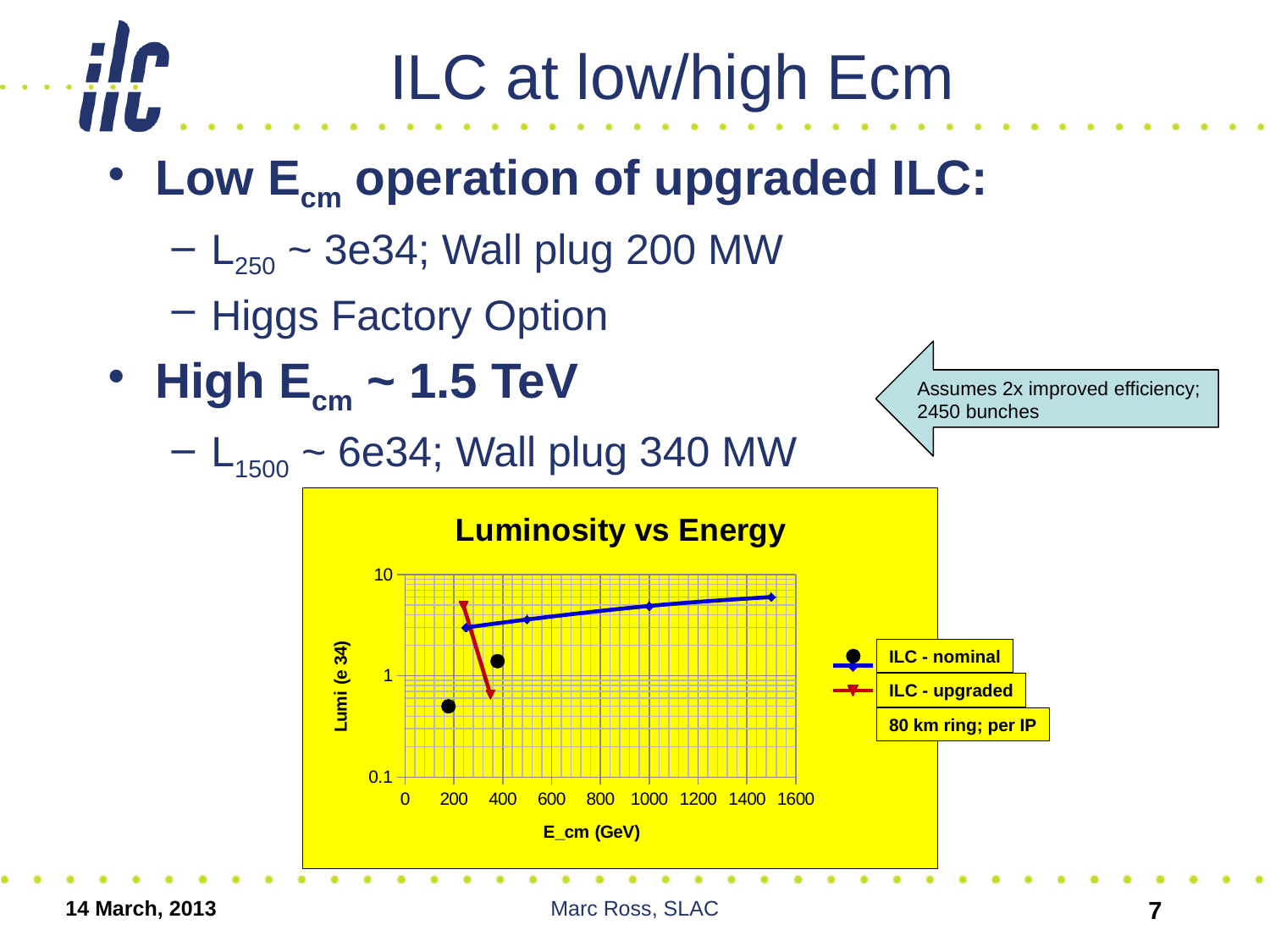
Is the ILC - upgraded luminosity at 1500 GeV greater or less than 1? greater How many entries does the chart's legend list? 3 Is the lowest ILC - nominal point (near 200 GeV) greater or less than 1? less Does the blue ILC - upgraded line rise or fall as E_cm increases from about 250 GeV to 1500 GeV? rises How many ILC - nominal data points are plotted on the chart? 2 What is the highest tick value shown on the x axis? 1600 What is the title of the chart? Luminosity vs Energy Which is higher: the ILC - upgraded luminosity at 1500 GeV or the ILC - nominal point near 200 GeV? ILC - upgraded at 1500 GeV Is the ILC - upgraded luminosity at 1500 GeV greater or less than 10? less What kind of chart is shown on the slide? line chart What is the label of the chart's x axis? E_cm (GeV)